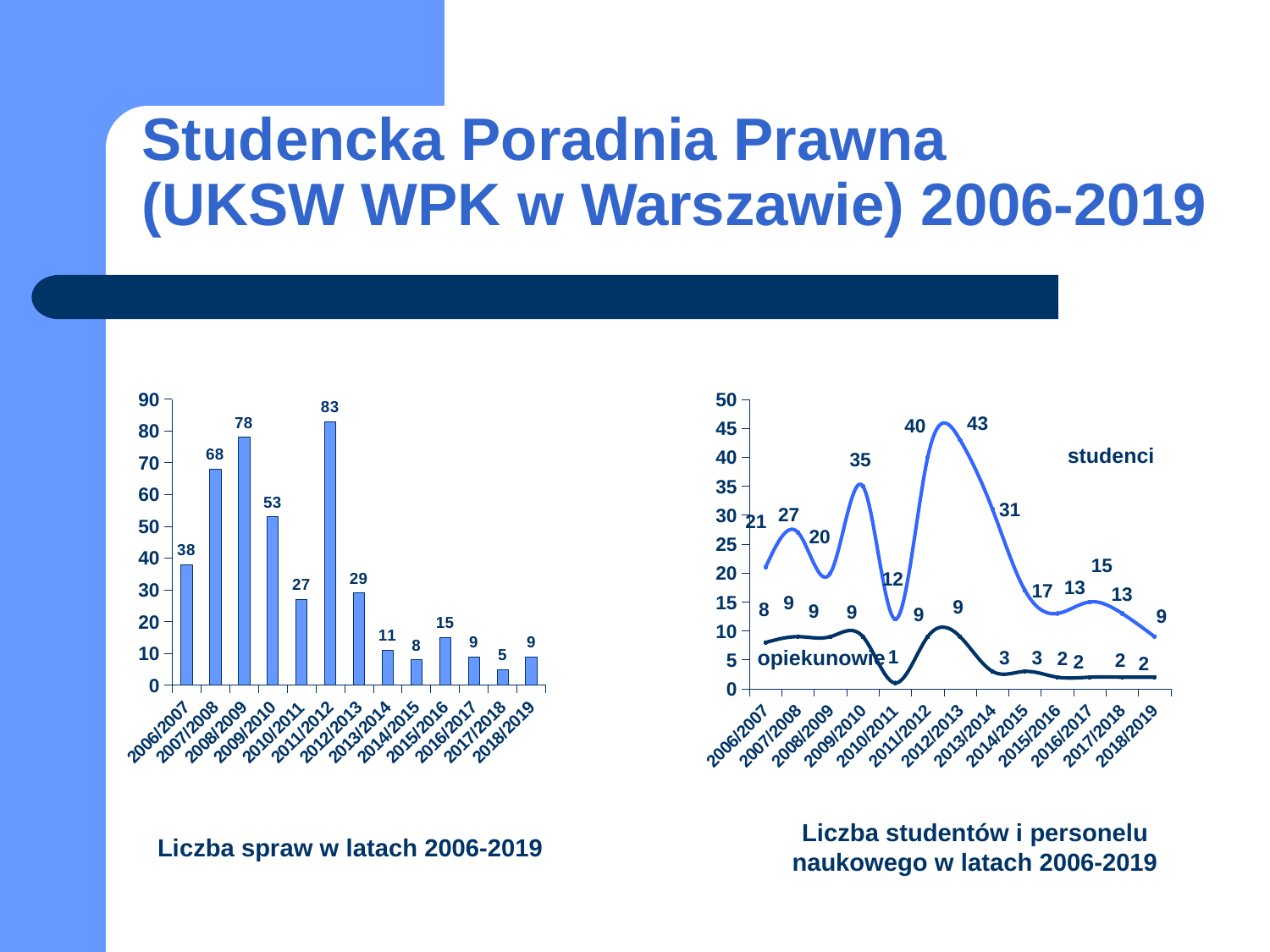
In the chart titled 'Liczba spraw w latach 2006-2019', which year has the highest value? 2011/2012 In the chart titled 'Liczba spraw w latach 2006-2019', which year has the lowest value? 2017/2018 In the chart titled 'Liczba studentów i personelu naukowego w latach 2006-2019', how many series are plotted? 2 In the chart titled 'Liczba spraw w latach 2006-2019', what is the value for 2011/2012? 83 In the chart titled 'Liczba studentów i personelu naukowego w latach 2006-2019', is the value for studenci in 2009/2010 larger than the value for studenci in 2013/2014? Yes In the chart titled 'Liczba spraw w latach 2006-2019', what is the difference between the values for 2008/2009 and 2009/2010? 25 In the chart titled 'Liczba studentów i personelu naukowego w latach 2006-2019', what is the value for studenci in 2012/2013? 43 What kind of chart is the one titled 'Liczba studentów i personelu naukowego w latach 2006-2019'? line chart In the chart titled 'Liczba studentów i personelu naukowego w latach 2006-2019', which year has the lowest value for studenci? 2018/2019 In the chart titled 'Liczba studentów i personelu naukowego w latach 2006-2019', what is the value for opiekunowie in 2010/2011? 1 What kind of chart is the one titled 'Liczba spraw w latach 2006-2019'? bar chart In the chart titled 'Liczba spraw w latach 2006-2019', how many years are shown on the x axis? 13